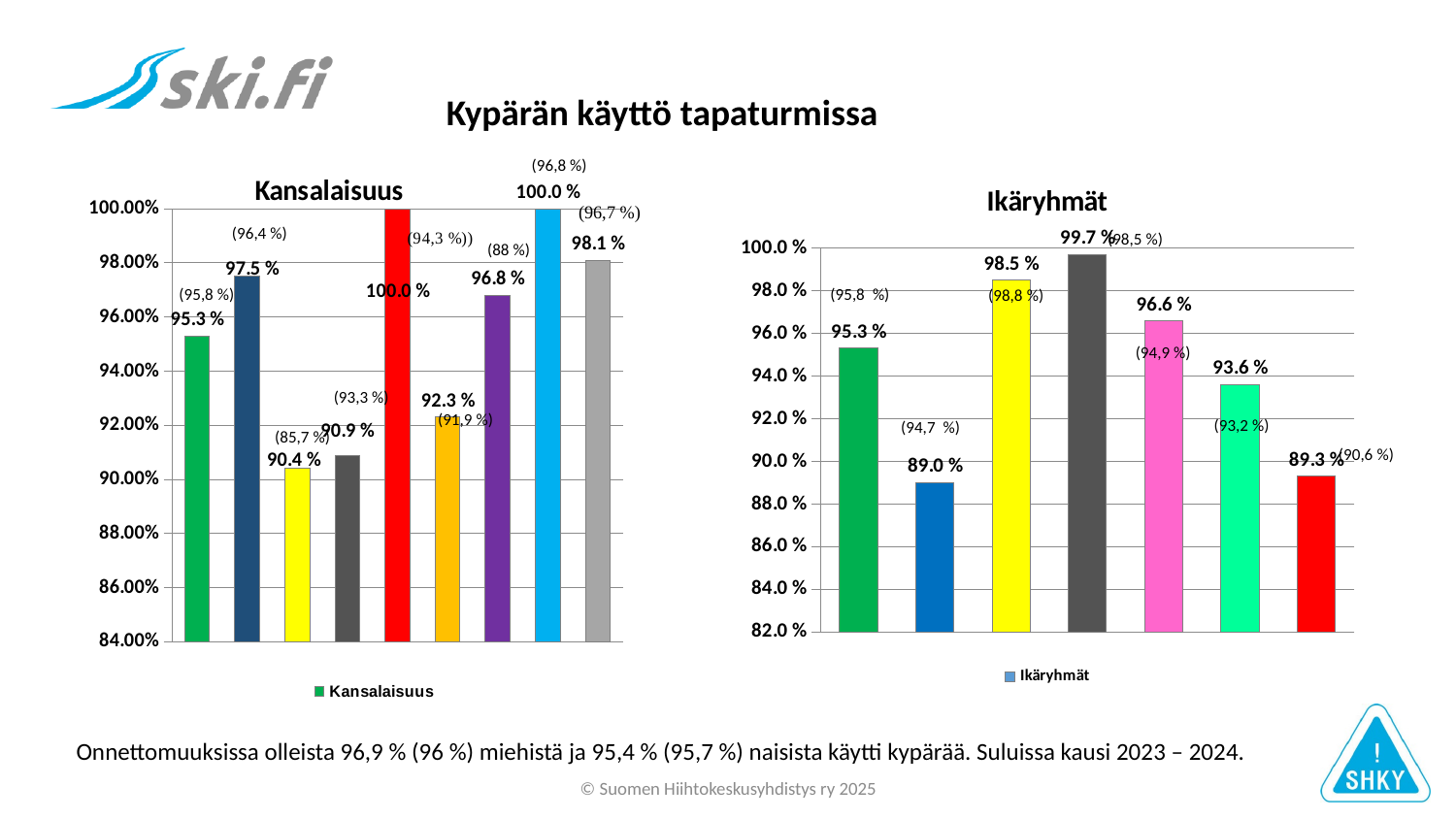
How many series does the legend of the Ikäryhmät chart list? 1 What is the title of the chart on the right side of the slide? Ikäryhmät In the Kansalaisuus chart, what is the lowest value shown by a data label? 90.4 % In the Ikäryhmät chart, what is the difference between the highest bar (99.7 %) and the lowest bar (89.0 %)? 10.7 % What type of chart is the Kansalaisuus chart? bar chart In the Ikäryhmät chart, what is the highest value shown by a data label? 99.7 % How many bars are plotted in the Kansalaisuus chart? 9 In the Kansalaisuus chart, how many bars reach 100.0 %? 2 How many bars are plotted in the Ikäryhmät chart? 7 In the Ikäryhmät chart, what is the value of the red bar on the far right? 89.3 % In the Ikäryhmät chart, what is the lowest value shown by a data label? 89.0 % In the Ikäryhmät chart, what is the value of the first (green) bar on the left? 95.3 %